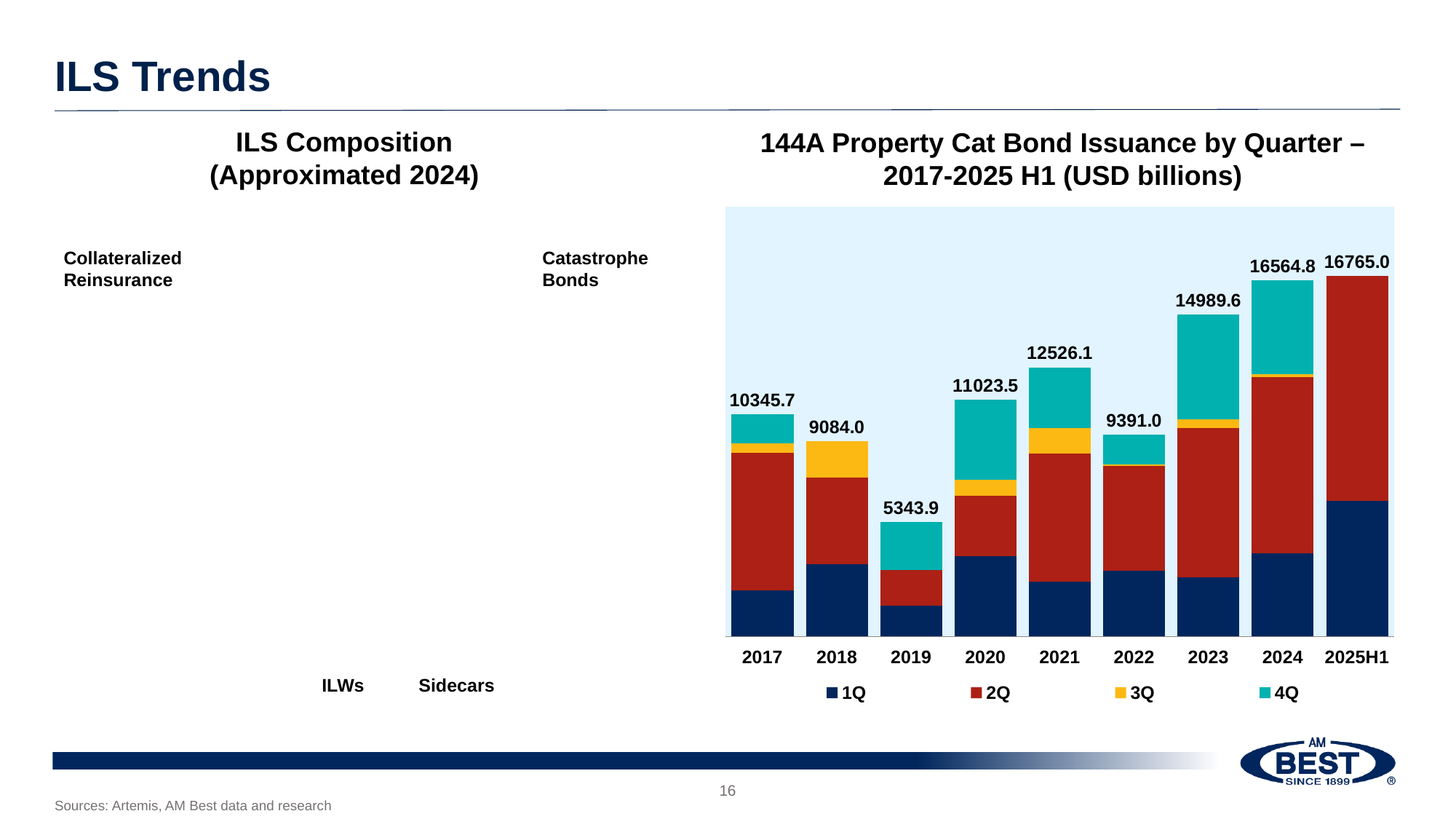
In the 144A Property Cat Bond Issuance by Quarter chart, which quarter series is shown in yellow? 3Q In the 144A Property Cat Bond Issuance by Quarter chart, what is the total issuance labeled for 2019? 5343.9 In the 144A Property Cat Bond Issuance by Quarter chart, what is the total issuance labeled for 2020? 11023.5 In the 144A Property Cat Bond Issuance by Quarter chart, what is the difference between the 2017 total and the 2018 total? 1261.7 What kind of chart is the 144A Property Cat Bond Issuance by Quarter chart? Stacked bar chart In the 144A Property Cat Bond Issuance by Quarter chart, which period has the highest total issuance? 2025H1 In the 144A Property Cat Bond Issuance by Quarter chart, which year has a larger total issuance, 2021 or 2022? 2021 How many series does the legend of the 144A Property Cat Bond Issuance by Quarter chart list? 4 In the 144A Property Cat Bond Issuance by Quarter chart, which year has the lowest total issuance? 2019 In the 144A Property Cat Bond Issuance by Quarter chart, do the total values rise or fall from 2022 to 2025H1? Rise How many periods are shown on the x axis of the 144A Property Cat Bond Issuance by Quarter chart? 9 In the 144A Property Cat Bond Issuance by Quarter chart, what is the difference between the 2024 total and the 2023 total? 1575.2